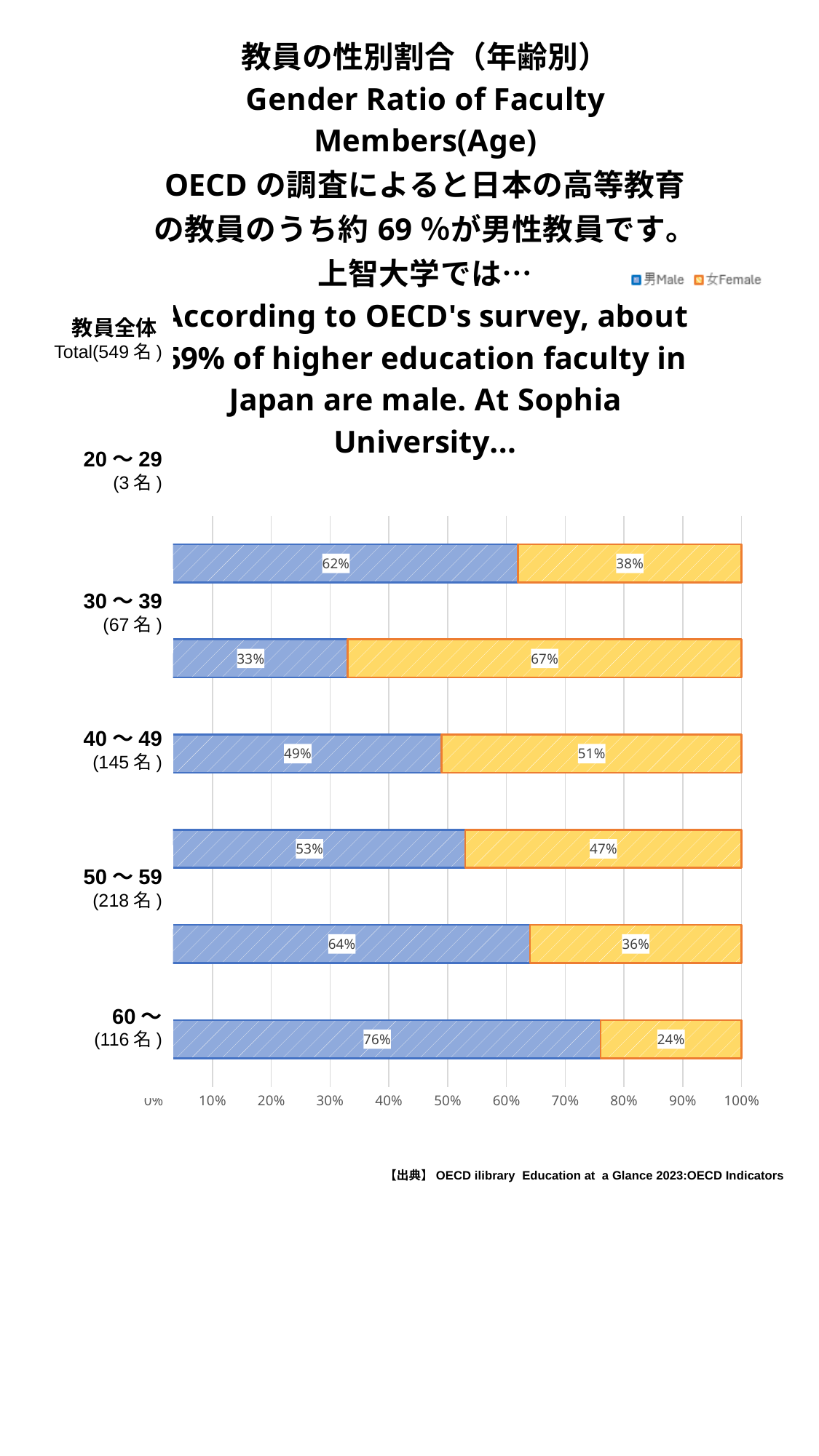
What is the Female (女Female) percentage shown on the second bar from the top? 67% What is the Male (男Male) percentage shown on the bottom bar of the chart? 76% What type of chart is shown on the slide? bar chart What are the two entries shown in the chart legend? 男Male and 女Female How many series does the chart legend list? 2 What is the total of the Male and Female segments in the top bar? 100% Which bar has the highest Male (男Male) percentage? the bottom bar (76%) In the third bar from the top, which is larger, the Male share or the Female share? Female How many stacked bars are plotted in the chart? 6 In the bottom bar, how much larger is the Male percentage than the Female percentage? 52% Which bar has the lowest Male (男Male) percentage? the second bar from the top (33%) What is the Female (女Female) percentage shown on the top bar of the chart? 38%